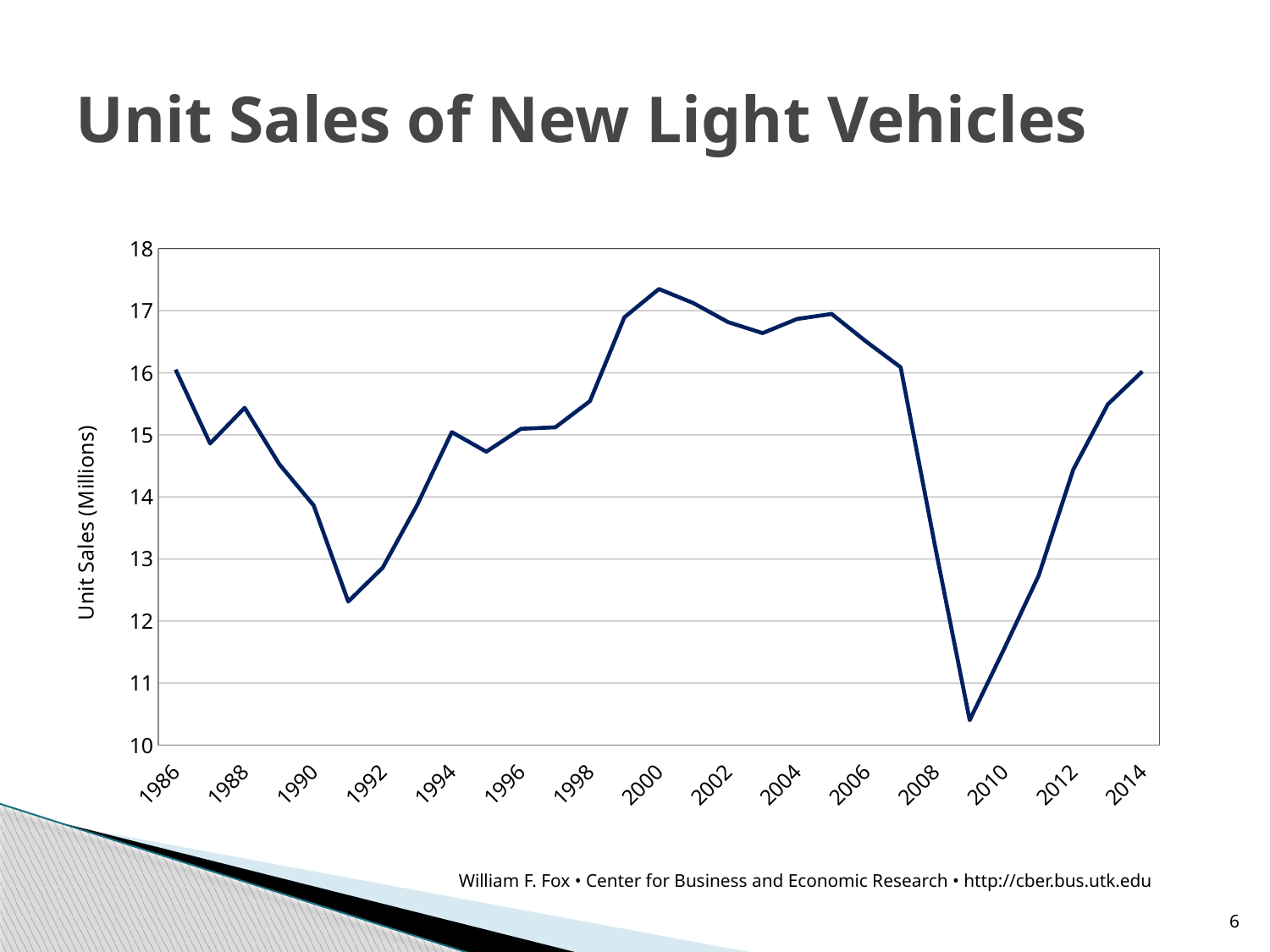
Is the value for 2009 greater or less than 11? less Is the value for 1991 greater or less than 13? less How many year labels are shown on the horizontal axis? 15 In which year does the line reach its lowest value? 2009 Is the value for 2000 greater or less than 17? greater What kind of chart is shown on the slide? line chart Which year has the larger value, 1991 or 2009? 1991 Do the values rise or fall between 2009 and 2014? rise In which year does the line reach its highest value? 2000 What is the label on the vertical axis of the chart? Unit Sales (Millions) What is the title of the chart? Unit Sales of New Light Vehicles